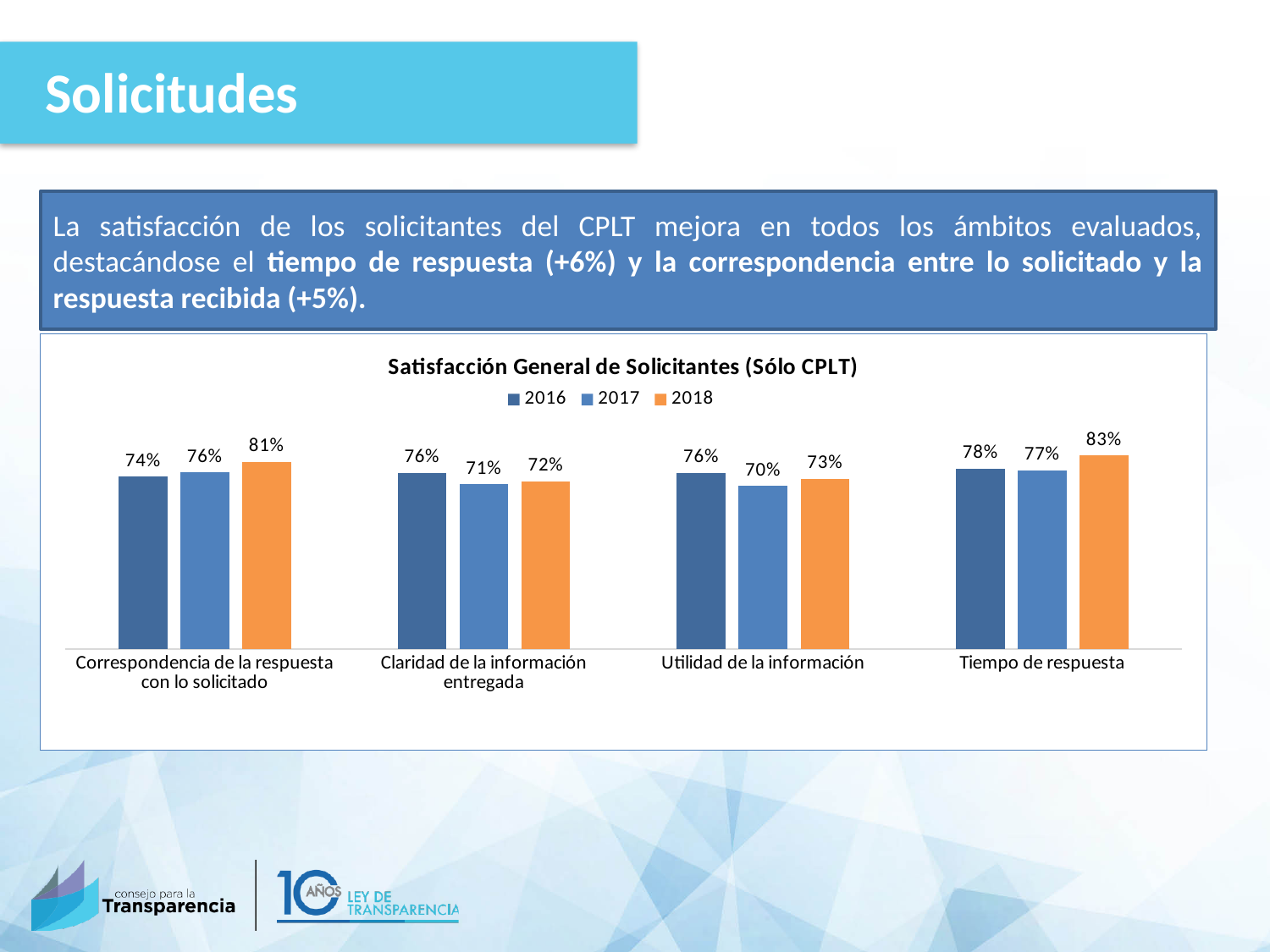
What is the 2016 value for Utilidad de la información? 76% What is the difference between the 2018 and 2016 values for Tiempo de respuesta? 5% What type of chart is shown? Bar chart What is the difference between the 2018 and 2017 values for Correspondencia de la respuesta con lo solicitado? 5% Which category has the lowest 2017 value? Utilidad de la información What is the 2018 value for Tiempo de respuesta? 83% Which category has the highest 2018 value? Tiempo de respuesta Which is larger for Claridad de la información entregada: the 2016 value or the 2018 value? 2016 How many categories are shown on the x axis? 4 What is the 2018 value for Correspondencia de la respuesta con lo solicitado? 81% What is the 2017 value for Claridad de la información entregada? 71% How many series does the legend list? 3